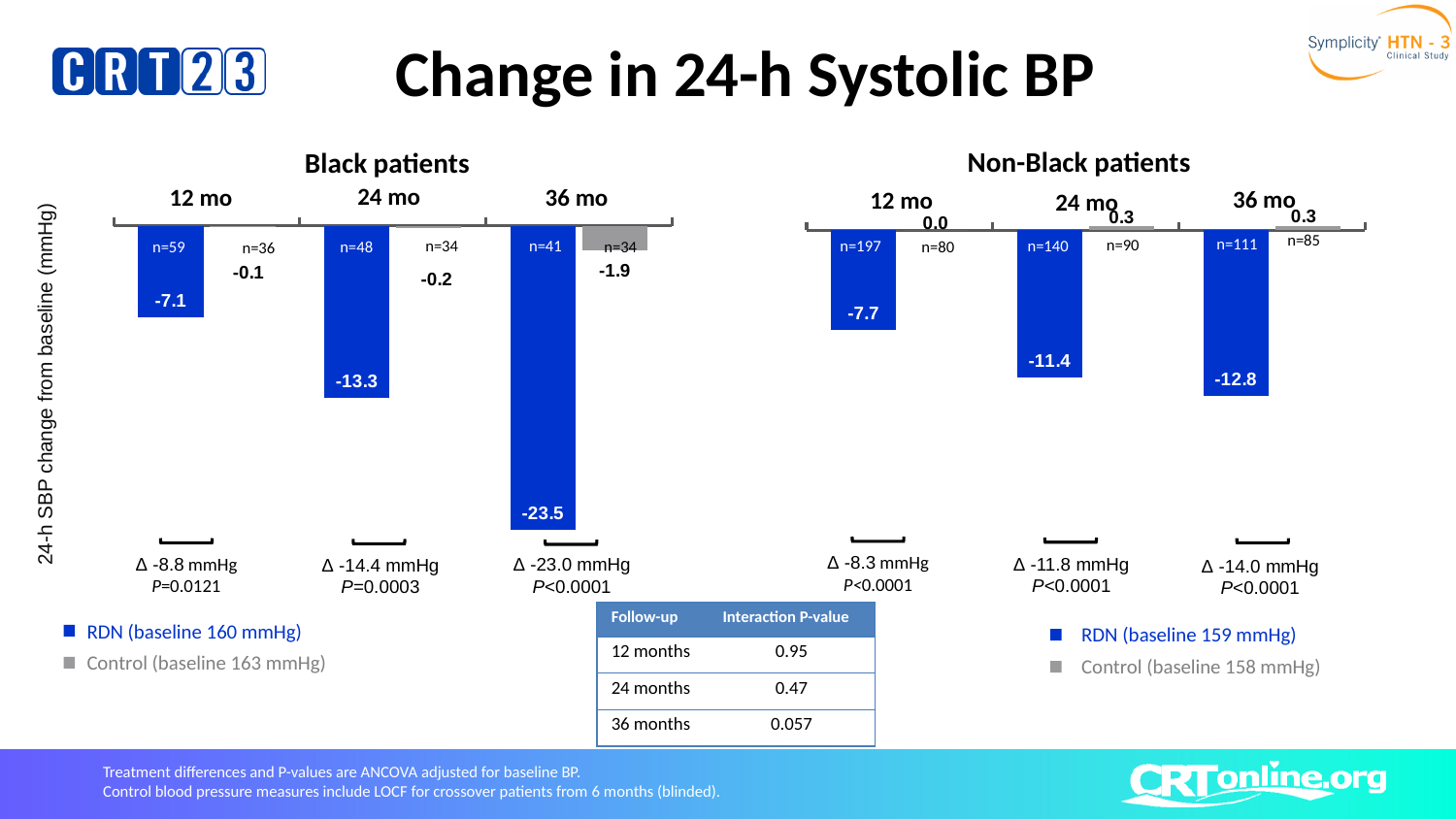
What type of chart is used for the Black patients data? Bar chart How many series does the legend list for the Non-Black patients chart? 2 In the Non-Black patients chart, at which time point is the RDN reduction smallest? 12 mo In the Non-Black patients chart, what is the Control value at 12 mo? 0.0 How many time points are shown on the x axis of the Black patients chart? 3 In the Black patients chart, what is the Control value at 36 mo? -1.9 In the Black patients chart, do the RDN values become more negative or less negative from 12 mo to 36 mo? More negative In the Black patients chart, what is the RDN value at 36 mo? -23.5 In the Black patients chart, what is the difference between the RDN values at 36 mo and 12 mo? 16.4 Which is a larger reduction: the RDN value at 12 mo for Black patients or for Non-Black patients? Non-Black patients (-7.7) In the Black patients chart, at which time point is the RDN bar the largest reduction? 36 mo In the Non-Black patients chart, what is the RDN value at 24 mo? -11.4